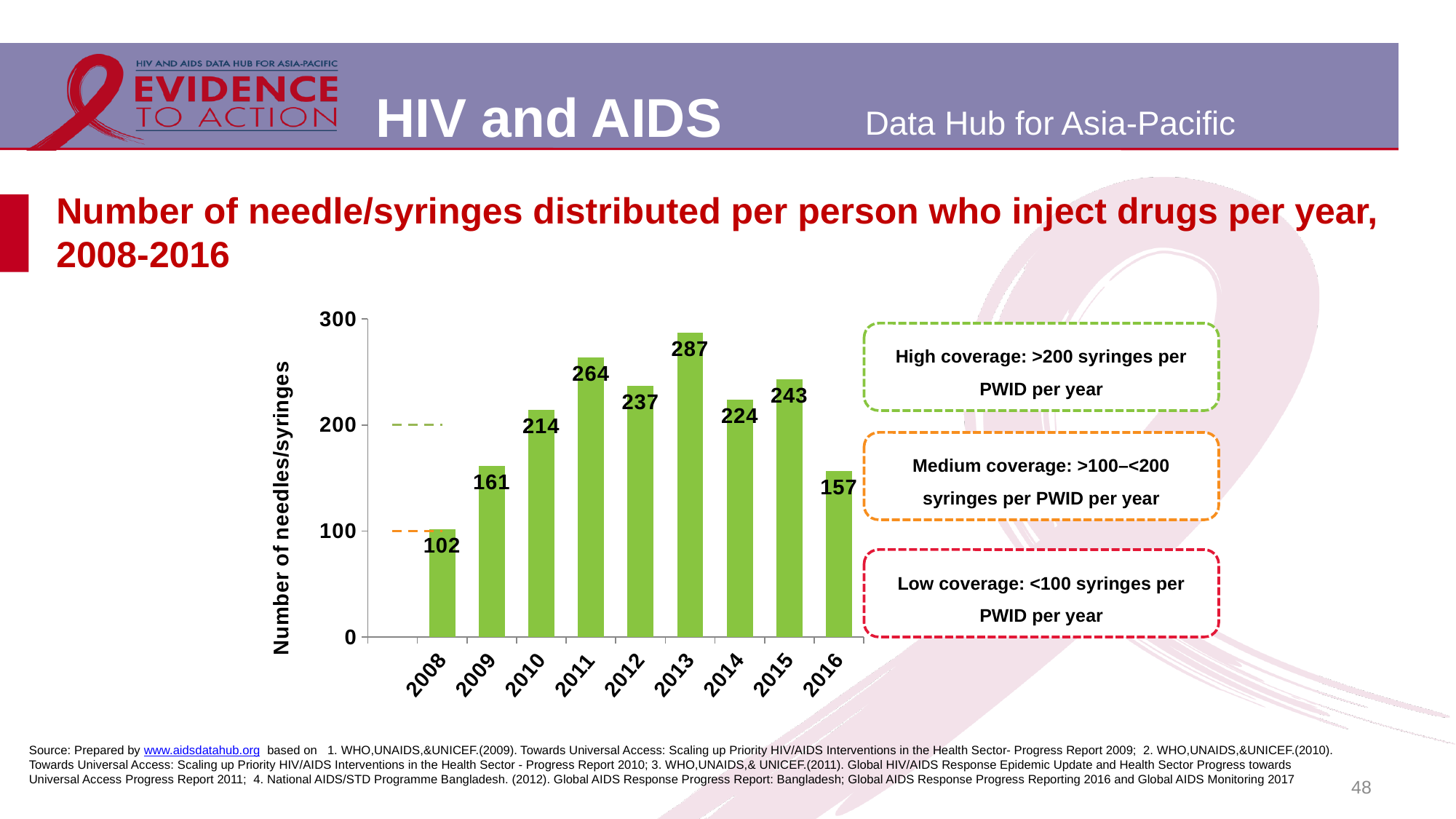
Which year has the highest number of needles/syringes distributed per PWID? 2013 What kind of chart is shown on the slide? Bar chart What is the number of needles/syringes distributed per person who injects drugs in 2013? 287 Is the value for 2010 greater or less than 200? greater What is the value shown for 2016? 157 What is the value shown for 2008? 102 Which year has a larger value, 2015 or 2014? 2015 Which year has the lowest number of needles/syringes distributed per PWID? 2008 What is the label of the y axis? Number of needles/syringes How many years are shown on the x axis? 9 What is the difference between the values for 2013 and 2008? 185 What is the difference between the values for 2011 and 2012? 27